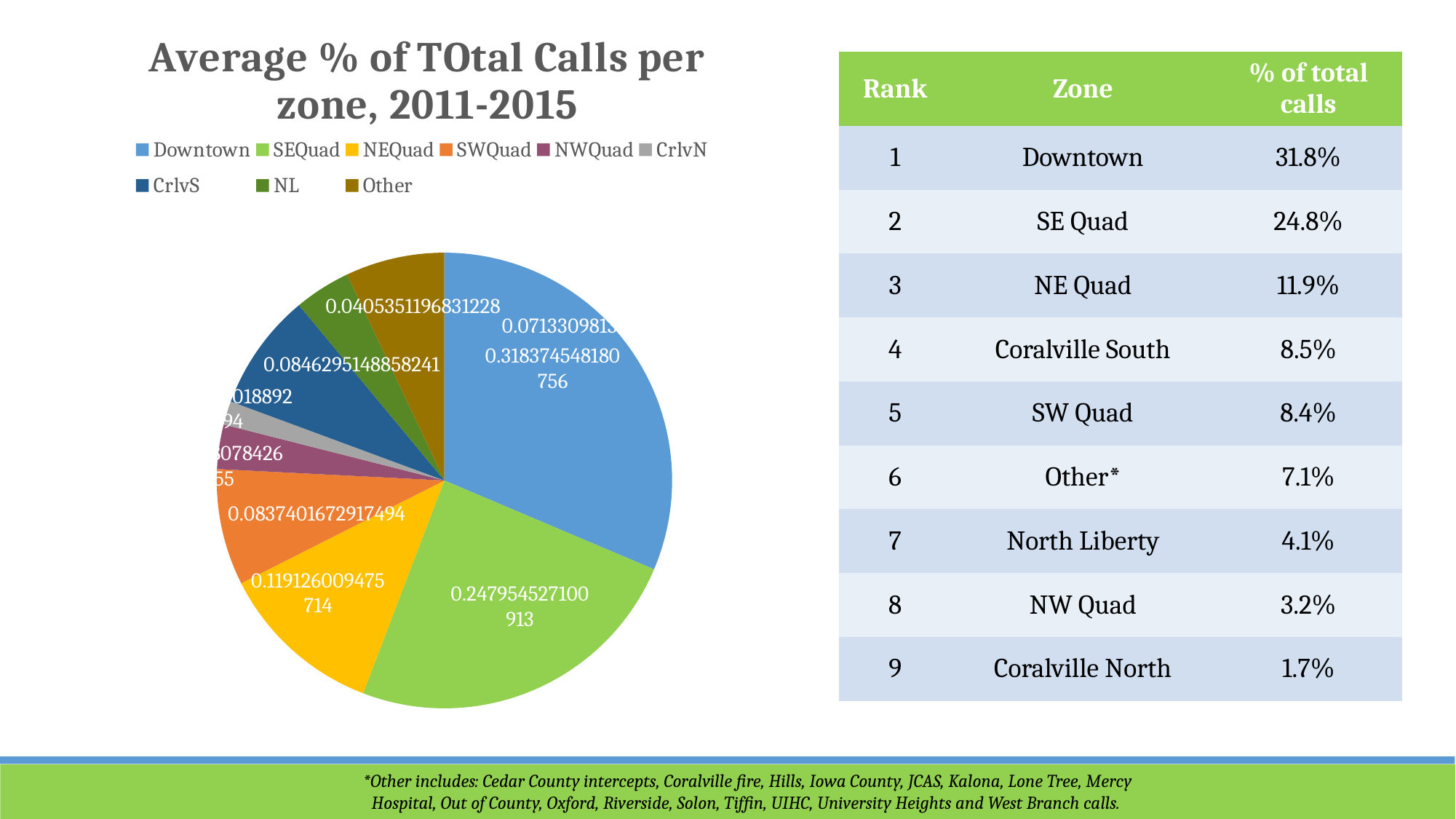
What kind of chart is shown on the slide? pie chart Which category has the smallest slice in the pie chart? CrlvN Which category has the largest slice in the pie chart? Downtown What value is labelled on the SWQuad slice of the pie chart? 0.0837401672917494 Which slice is larger in the pie chart, SEQuad or NEQuad? SEQuad What colour is the Downtown slice in the pie chart? blue How many categories does the pie chart's legend list? 9 What value is labelled on the SEQuad slice of the pie chart? 0.247954527100913 What is the title of the pie chart? Average % of TOtal Calls per zone, 2011-2015 What value is labelled on the Downtown slice of the pie chart? 0.318374548180756 What value is labelled on the CrlvS slice of the pie chart? 0.0846295148858241 What value is labelled on the NEQuad slice of the pie chart? 0.119126009475714